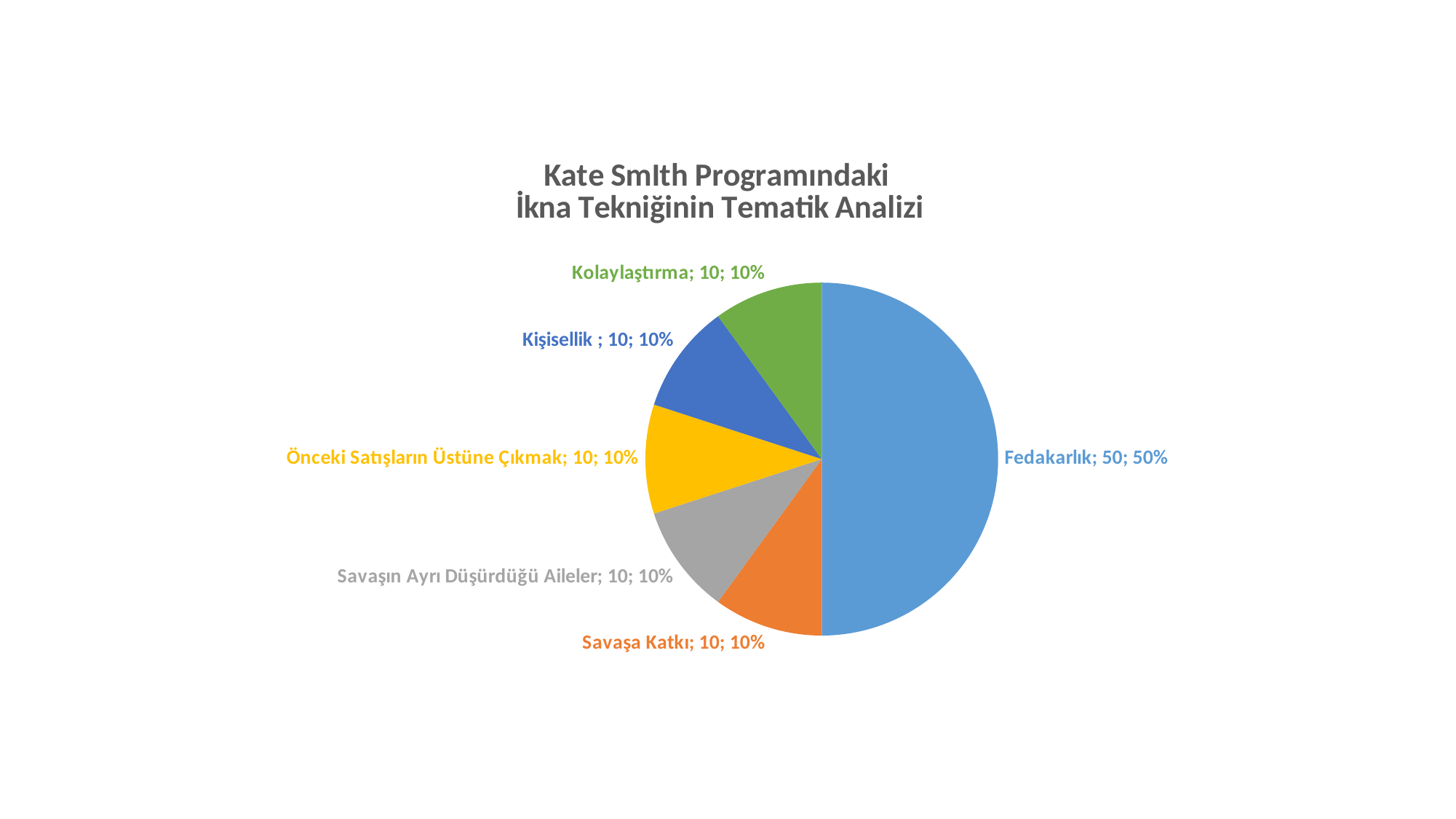
Which category has the largest slice? Fedakarlık What kind of chart is shown on the slide? Pie chart What is the value for Fedakarlık? 50 What share of the pie does Fedakarlık represent? 50% What is the title of the chart? Kate SmIth Programındaki İkna Tekniğinin Tematik Analizi What share of the pie does Kolaylaştırma represent? 10% How many slices does the pie chart have? 6 What colour is the Savaşa Katkı slice? Orange What is the difference between the values for Fedakarlık and Kişisellik? 40 Which is larger, the value for Fedakarlık or the value for Önceki Satışların Üstüne Çıkmak? Fedakarlık What is the value for Savaşın Ayrı Düşürdüğü Aileler? 10 What is the value for Savaşa Katkı? 10